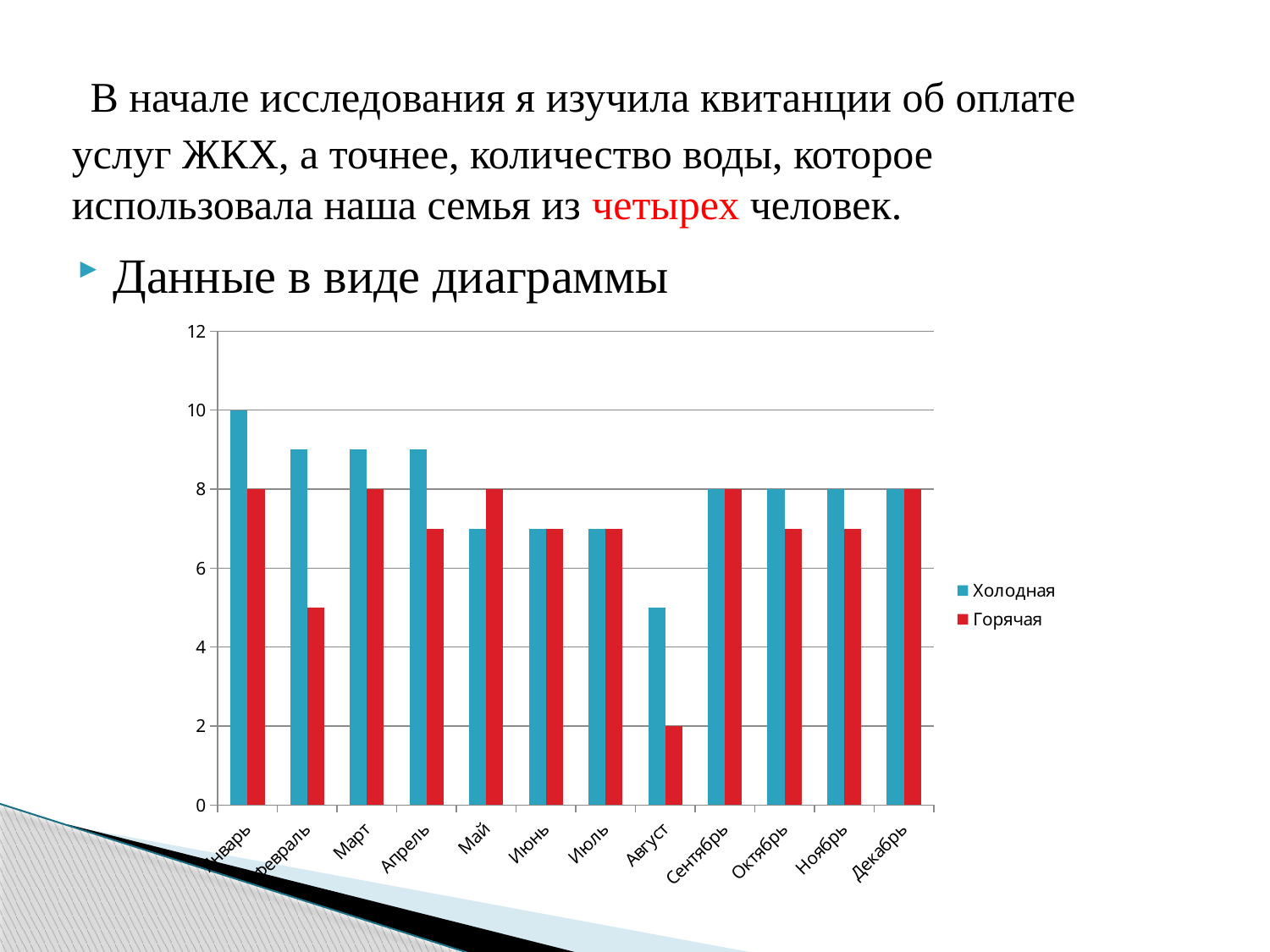
What is the value of Горячая for Сентябрь? 8 Which month has the highest value for Холодная? Январь In Февраль, which is larger: Холодная or Горячая? Холодная What is the difference between Холодная and Горячая in Январь? 2 What is the value of Холодная for Январь? 10 How many months (categories) are shown on the x axis? 12 Which colour represents the Горячая series? red What type of chart is shown on the slide? bar chart What is the value of Горячая for Август? 2 Is the value for Горячая in Февраль greater or less than 6? less How many series does the legend list? 2 Which month has the lowest value for Горячая? Август